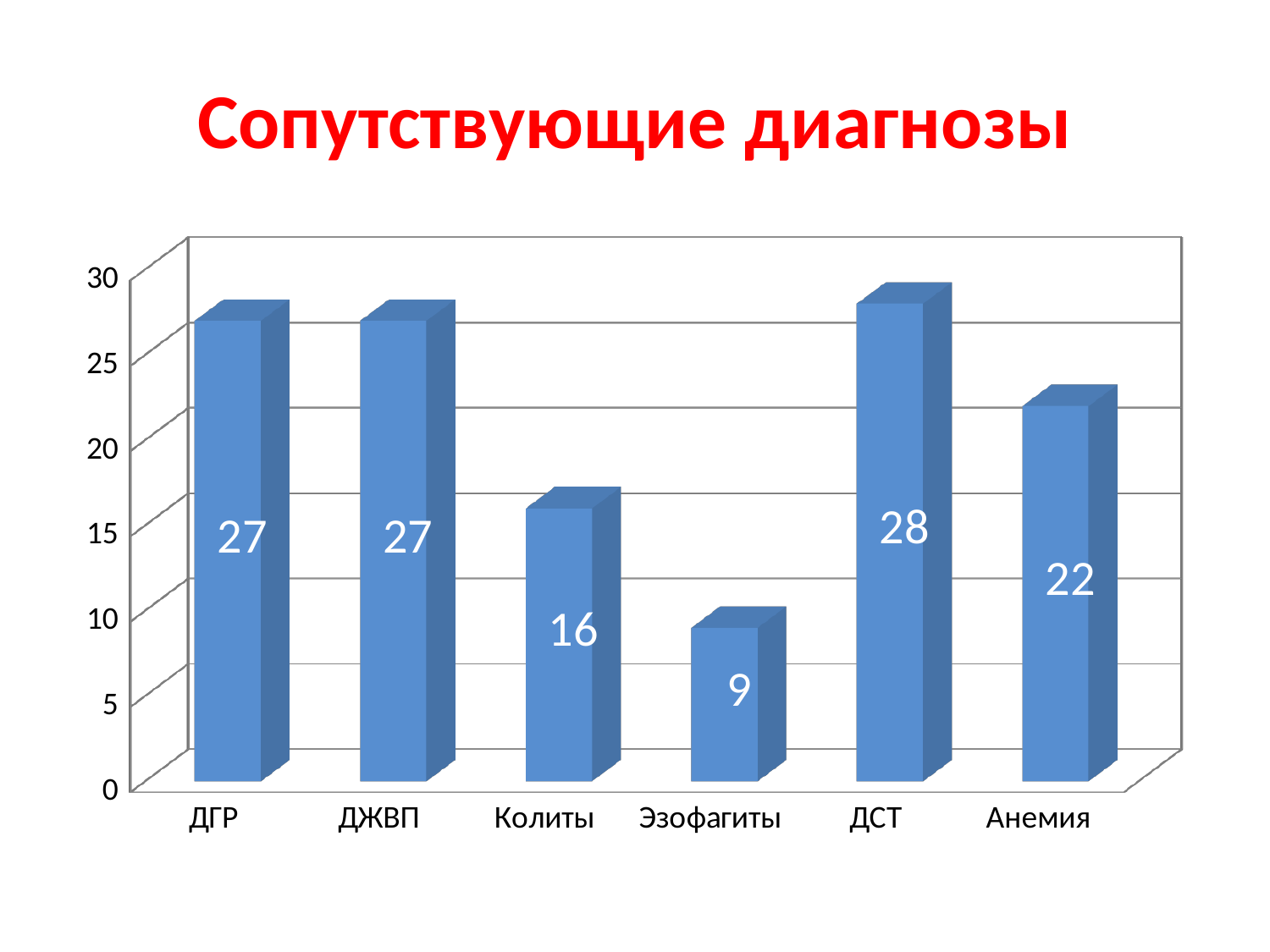
What is the difference between the values for ДСТ and Эзофагиты? 19 What kind of chart is shown on the slide? Bar chart What is the value for Анемия? 22 How many categories are shown on the x axis? 6 Which is larger, the value for Колиты or the value for Анемия? Анемия What is the title of the slide? Сопутствующие диагнозы What is the difference between the values for ДГР and Анемия? 5 What is the value for Колиты? 16 What is the value for Эзофагиты? 9 What is the value for ДСТ? 28 Which category has the highest value? ДСТ Which category has the lowest value? Эзофагиты